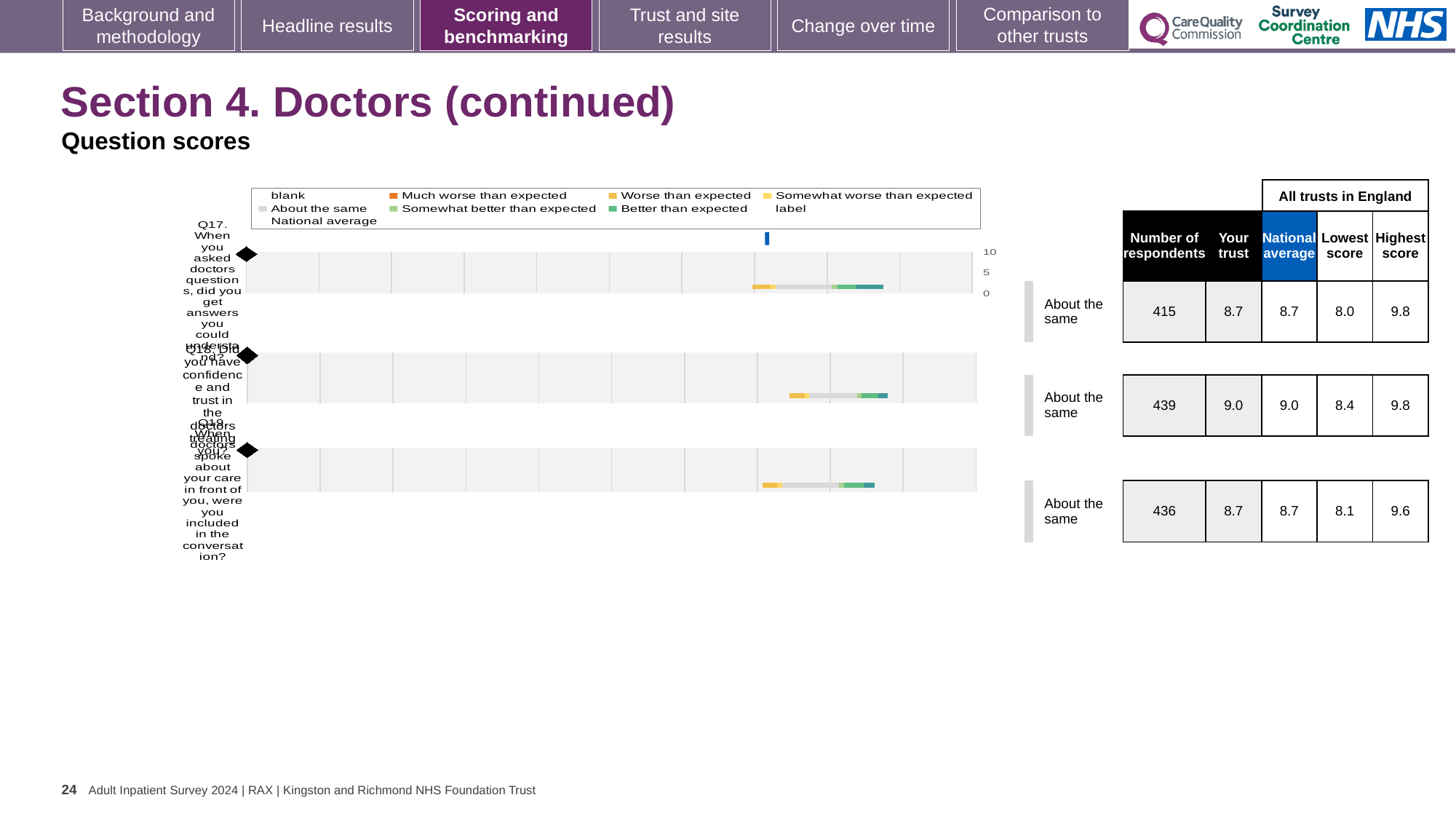
What is the benchmark category shown for Q17 in the chart? About the same What is the number of respondents for Q17 in the table beside the chart? 415 What is the 'Your trust' score for Q18 in the table beside the chart? 9.0 What is the difference between the highest score and the lowest score for Q19 in the table beside the chart? 1.5 How many entries does the chart legend list? 9 What kind of chart is shown on the slide? bar chart What is the maximum value shown on the chart's axis? 10 What is the benchmark category shown for Q19 in the chart? About the same How many questions (categories) are plotted in the chart? 3 Which question has the highest 'Your trust' score in the table beside the chart? Q18 Which has more respondents in the table beside the chart, Q18 or Q19? Q18 Which legend entry is shown in orange in the chart legend? Much worse than expected